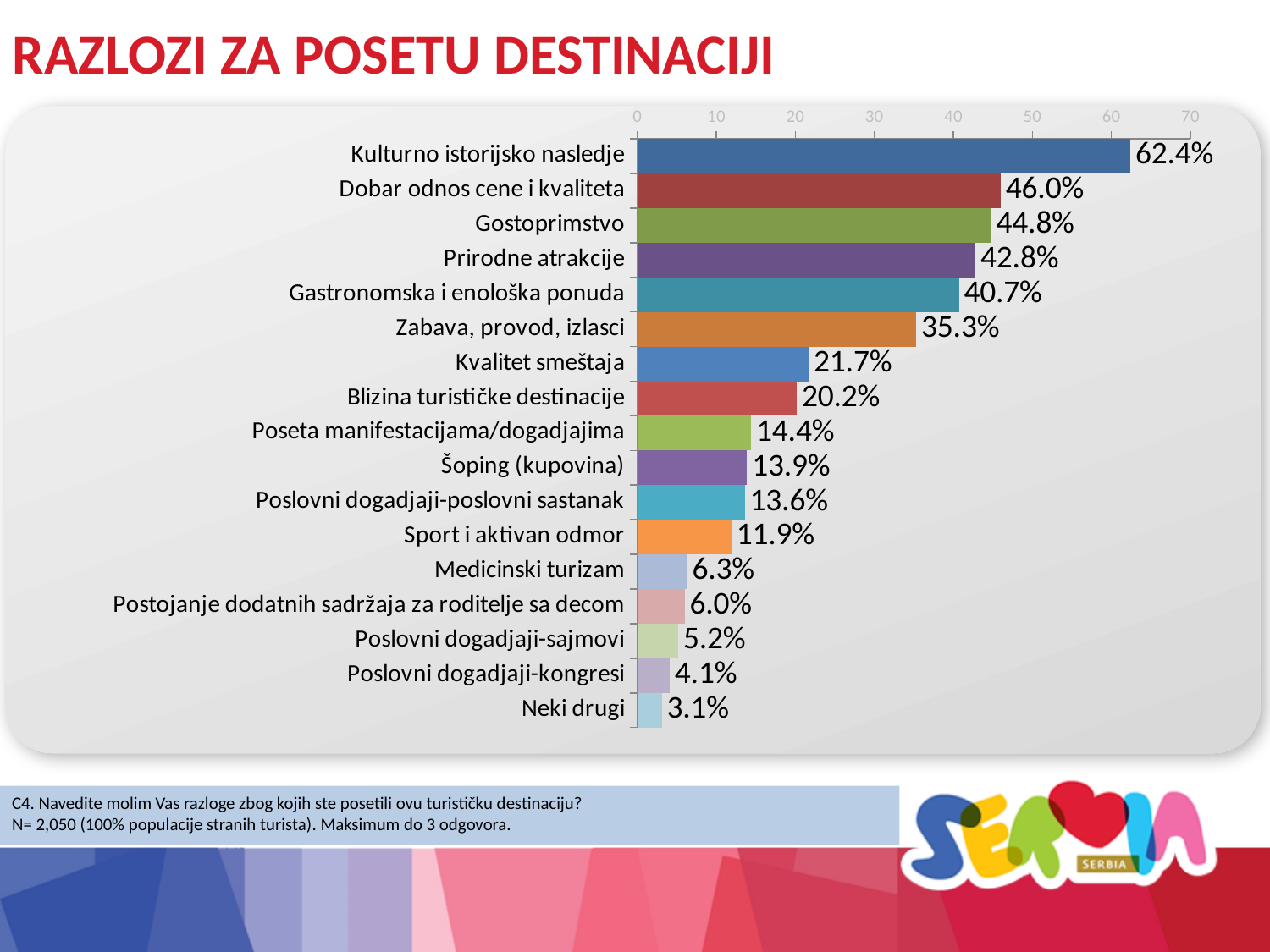
What is the difference between Dobar odnos cene i kvaliteta and Gostoprimstvo? 1.2% Which category has the highest value? Kulturno istorijsko nasledje What is the difference between Kulturno istorijsko nasledje and Zabava, provod, izlasci? 27.1% What is the value for Medicinski turizam? 6.3% What kind of chart is shown on the slide? Bar chart Which is larger, Kvalitet smeštaja or Sport i aktivan odmor? Kvalitet smeštaja What is the title of the slide? RAZLOZI ZA POSETU DESTINACIJI Is the value for Prirodne atrakcije greater or less than 40? greater How many categories are shown in the chart? 17 What is the value for Gastronomska i enološka ponuda? 40.7% What is the value for Kulturno istorijsko nasledje? 62.4% Which category has the lowest value? Neki drugi